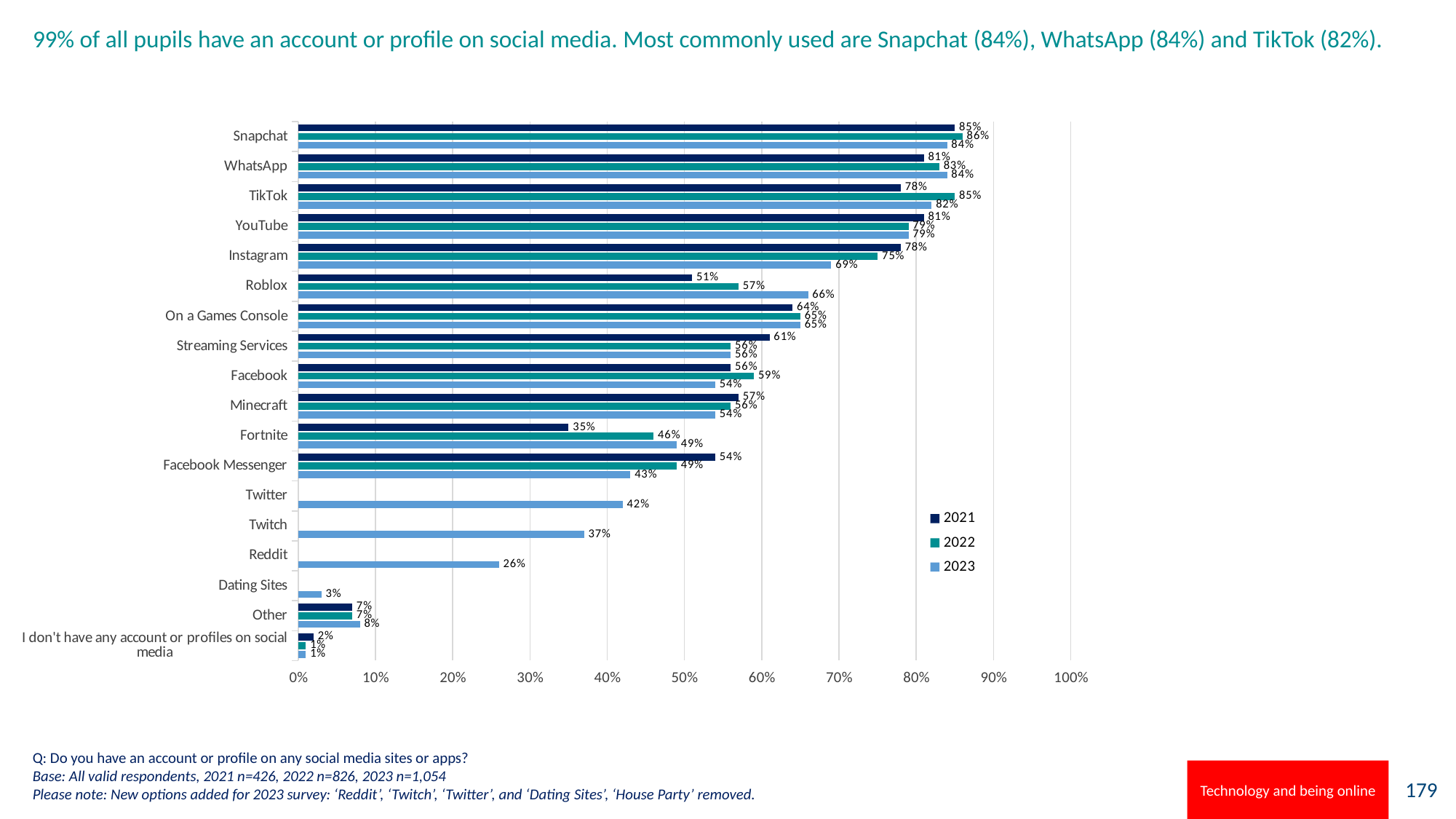
How many series does the legend list? 3 Is the value for Reddit in 2023 greater or less than 30%? less Which is larger in 2023: Roblox or Facebook Messenger? Roblox What kind of chart is shown on the slide? bar chart What is the value for Snapchat in 2023? 84% Do the values for Facebook Messenger rise or fall from 2021 to 2023? fall What is the difference between the 2023 and 2021 values for Fortnite? 14 percentage points Which category has the lowest value for 2023? I don't have any account or profiles on social media How many categories are shown on the chart? 18 Which category has the highest value for 2021? Snapchat What is the value for Roblox in 2023? 66% What is the value for Twitch in 2023? 37%